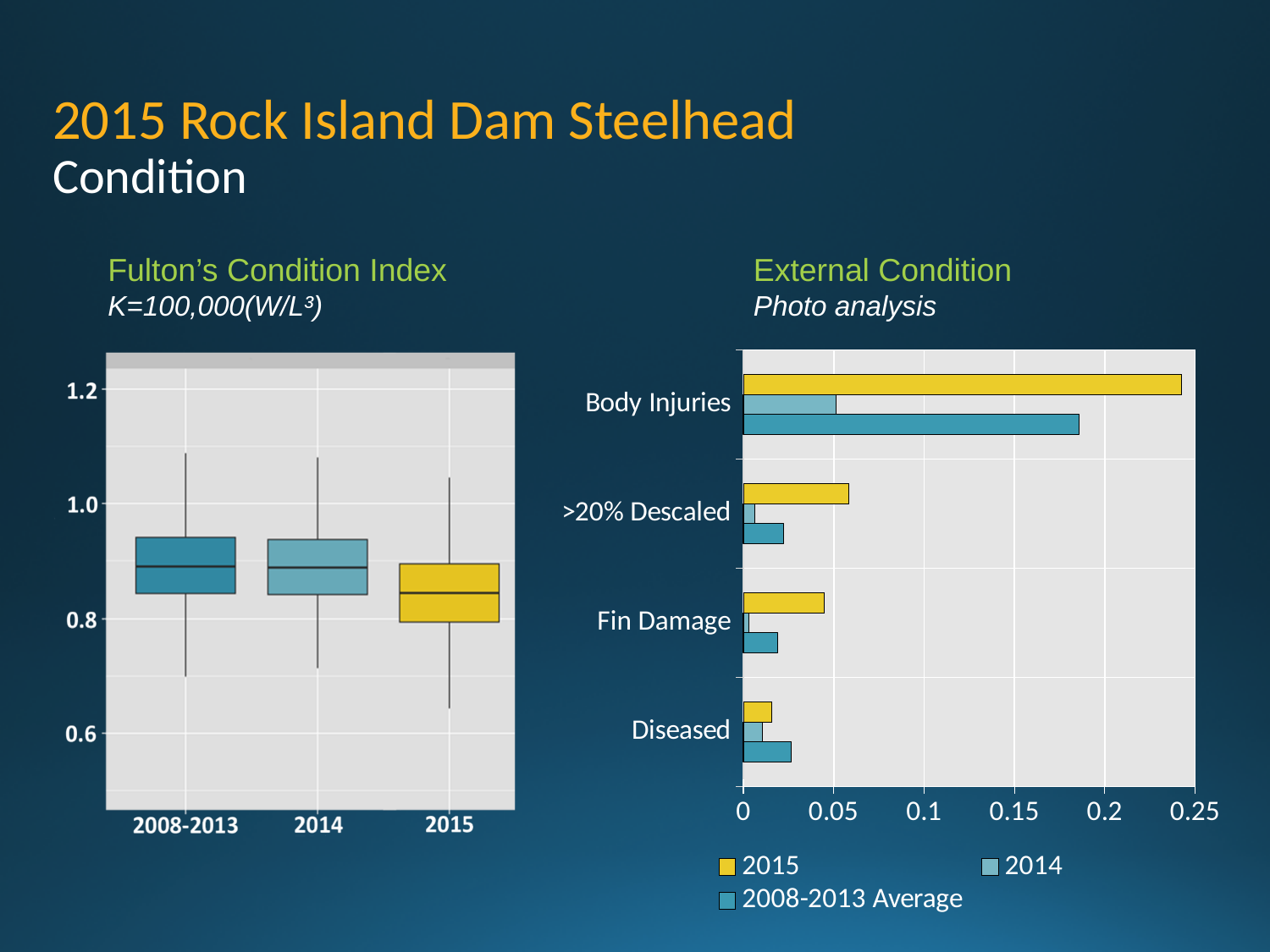
On the Fulton's Condition Index chart, how many groups are shown on the x axis? 3 On the External Condition chart, is the 2015 value for Fin Damage greater or less than 0.05? less What kind of chart is the Fulton's Condition Index chart on the left? box plot How many categories are shown on the External Condition chart? 4 On the External Condition chart, is the 2015 value for Body Injuries greater or less than 0.2? greater On the Fulton's Condition Index chart, is the median for 2015 greater or less than 1.0? less On the External Condition chart, for Body Injuries, which is larger: the 2014 value or the 2008-2013 Average value? 2008-2013 Average On the External Condition chart, what colour are the bars for the 2015 series? yellow How many series does the legend of the External Condition chart list? 3 What kind of chart is the External Condition chart on the right? bar chart On the External Condition chart, which category has the lowest value for the 2015 series? Diseased On the External Condition chart, which category has the highest value for the 2015 series? Body Injuries